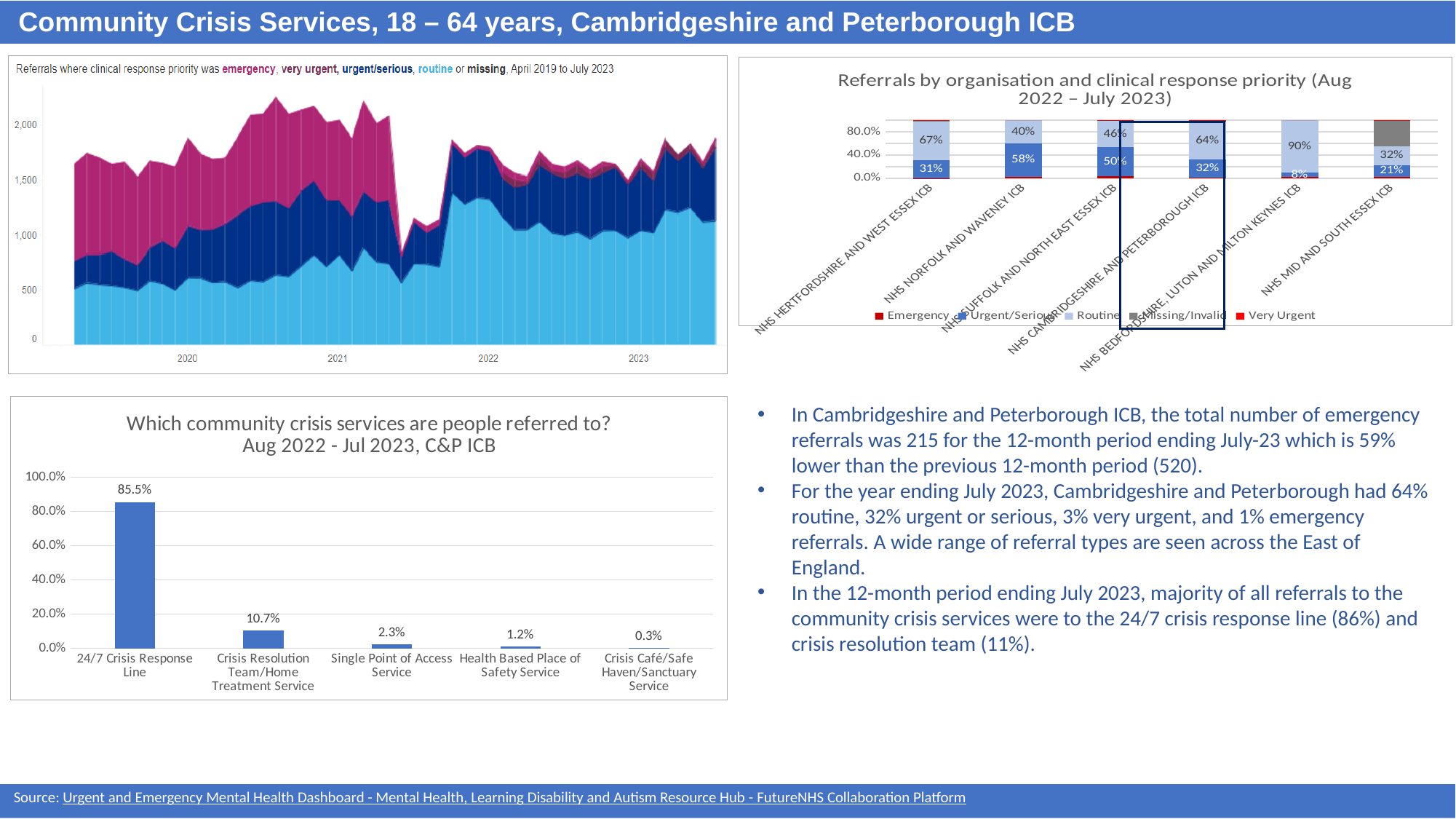
In the chart 'Which community crisis services are people referred to?', what is the value for Crisis Resolution Team/Home Treatment Service? 10.7% In the chart 'Referrals by organisation and clinical response priority', which organisation has the highest Routine percentage? NHS Bedfordshire, Luton and Milton Keynes ICB In the chart 'Referrals by organisation and clinical response priority', what is the Routine percentage for NHS Cambridgeshire and Peterborough ICB? 64% In the chart 'Referrals by organisation and clinical response priority', is the Routine percentage larger for NHS Hertfordshire and West Essex ICB or NHS Suffolk and North East Essex ICB? NHS Hertfordshire and West Essex ICB In the chart 'Which community crisis services are people referred to?', how many services are shown on the x axis? 5 In the chart 'Referrals by organisation and clinical response priority', what is the Urgent/Serious percentage for NHS Norfolk and Waveney ICB? 58% In the chart 'Referrals by organisation and clinical response priority', how many series does the legend list? 5 In the chart 'Which community crisis services are people referred to?', what percentage of referrals went to the 24/7 Crisis Response Line? 85.5% In the chart 'Which community crisis services are people referred to?', which service has the lowest share of referrals? Crisis Café/Safe Haven/Sanctuary Service In the top-left chart of referrals by clinical response priority, which year labels appear on the x axis? 2020, 2021, 2022, 2023 What type of chart is 'Which community crisis services are people referred to?'? Bar chart In the chart 'Which community crisis services are people referred to?', what is the difference between the Single Point of Access Service and the Health Based Place of Safety Service values? 1.1%